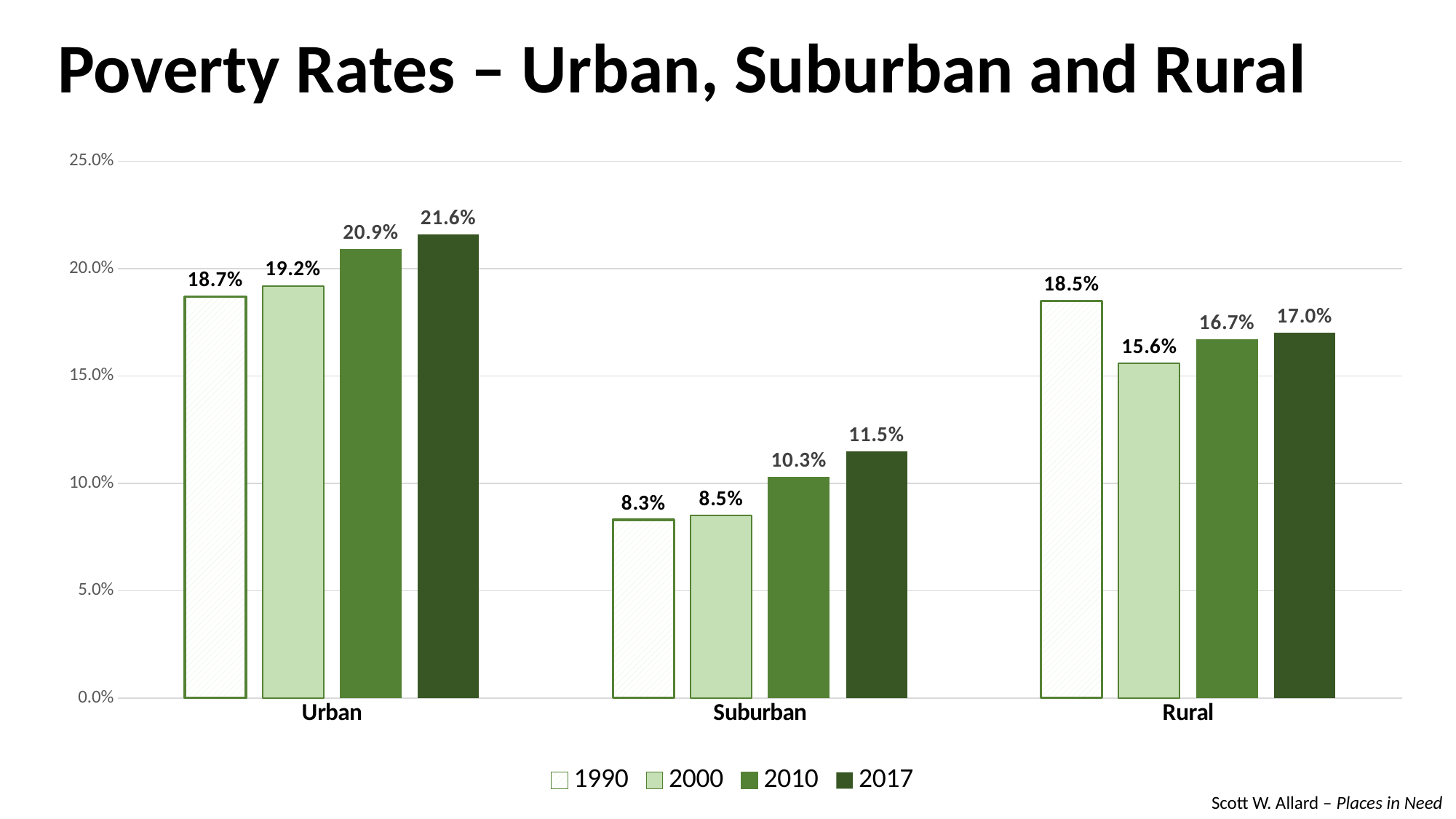
Which category had the lowest poverty rate in 2017? Suburban What was the poverty rate for Rural areas in 2000? 15.6% What kind of chart is shown on the slide? Bar chart Which category had the highest poverty rate in 2010? Urban Which was larger in 1990, the Urban poverty rate or the Rural poverty rate? Urban How many categories are shown on the x axis? 3 Did the Suburban poverty rate rise or fall from 1990 to 2017? Rise What was the poverty rate for Urban areas in 2017? 21.6% What is the difference between the Urban and Suburban poverty rates in 2017? 10.1% Is the Suburban poverty rate in 2010 greater or less than 10.0%? greater What was the poverty rate for Suburban areas in 1990? 8.3% How many series does the legend list? 4